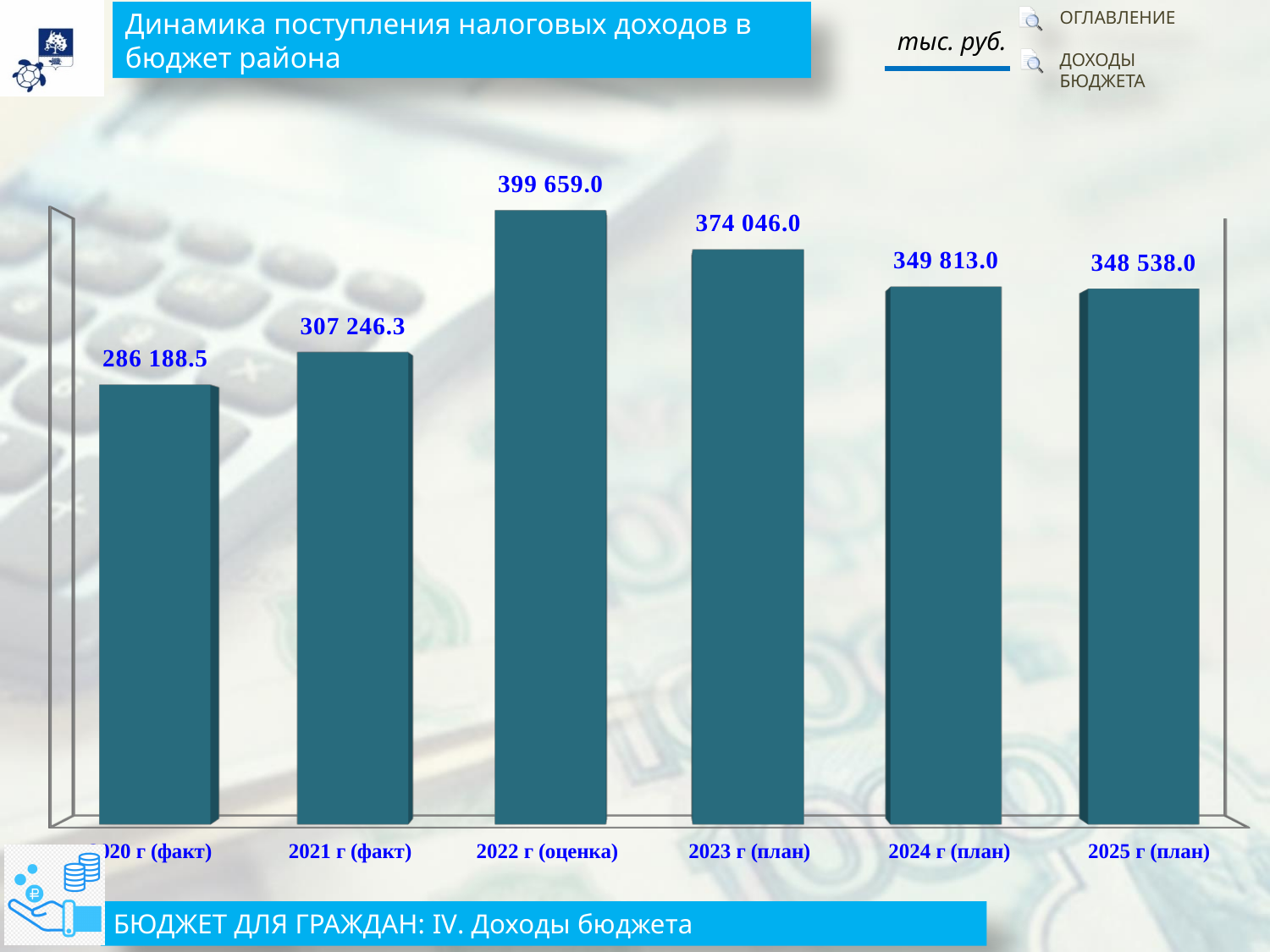
In what units are the values on the chart given? тыс. руб. What is the difference between the values for 2022 г (оценка) and 2020 г (факт)? 113 470.5 What kind of chart is shown on the slide? Bar chart Which category has the lowest value? 2020 г (факт) Which is larger, the value for 2021 г (факт) or the value for 2023 г (план)? 2023 г (план) Which category has the highest value? 2022 г (оценка) What is the value for 2023 г (план)? 374 046.0 What is the value for 2025 г (план)? 348 538.0 From 2022 г (оценка) to 2025 г (план), do the values rise or fall? Fall What is the difference between the values for 2023 г (план) and 2024 г (план)? 24 233.0 How many categories are shown in the chart? 6 What is the value for 2021 г (факт)? 307 246.3